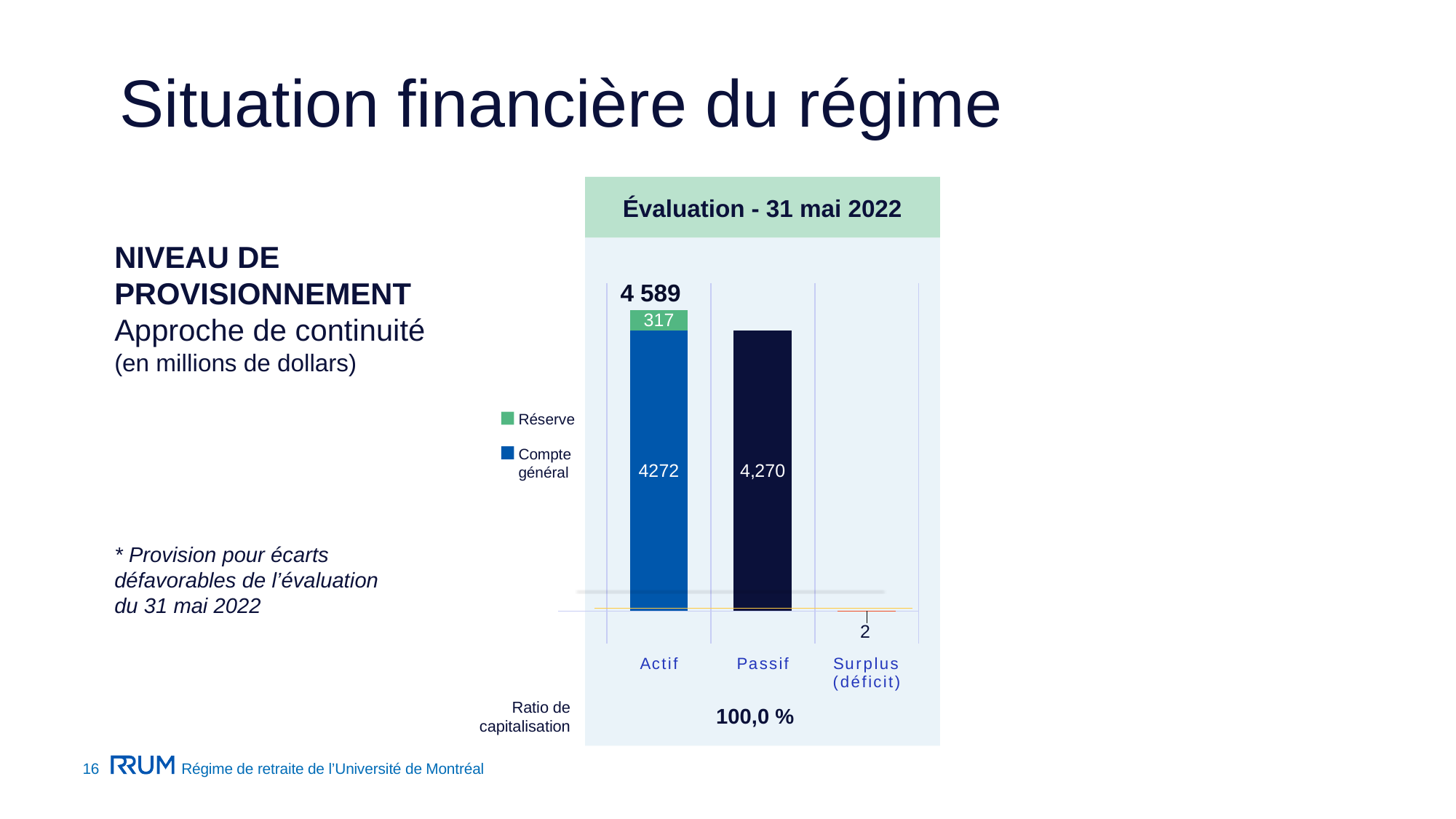
What kind of chart is shown? Stacked bar chart What is the value of the Réserve segment for Actif? 317 Which category has the lowest value? Surplus (déficit) What is the Ratio de capitalisation shown below the chart? 100,0 % Is the Actif total larger or the Passif value larger? Actif How many series does the legend list? 2 What is the total of the stacked Actif bar? 4 589 What is the value of the Compte général segment for Actif? 4272 What is the value shown for Passif? 4,270 How many categories are shown on the x axis? 3 What is the value shown for Surplus (déficit)? 2 Which category has the highest total value? Actif